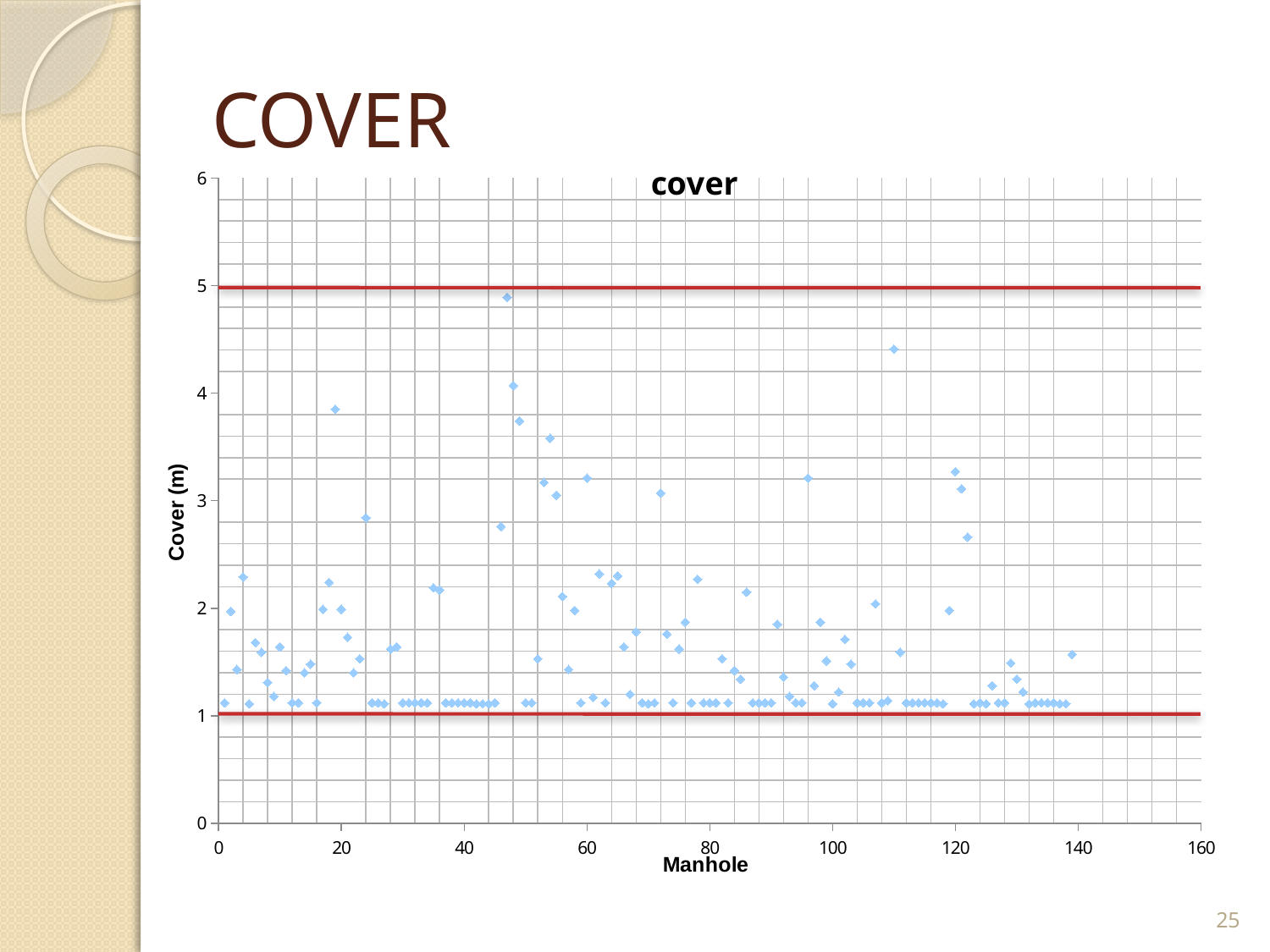
Is the highest plotted cover value greater or less than 4? greater Is the highest plotted cover value greater or less than 5? less Is the cover value for the point near manhole 110 greater or less than 4? greater What is the label of the y axis? Cover (m) What kind of chart is shown on the slide? scatter chart What is the highest value shown on the x axis (Manhole)? 160 What is the title of the chart? cover What is the highest value shown on the y axis? 6